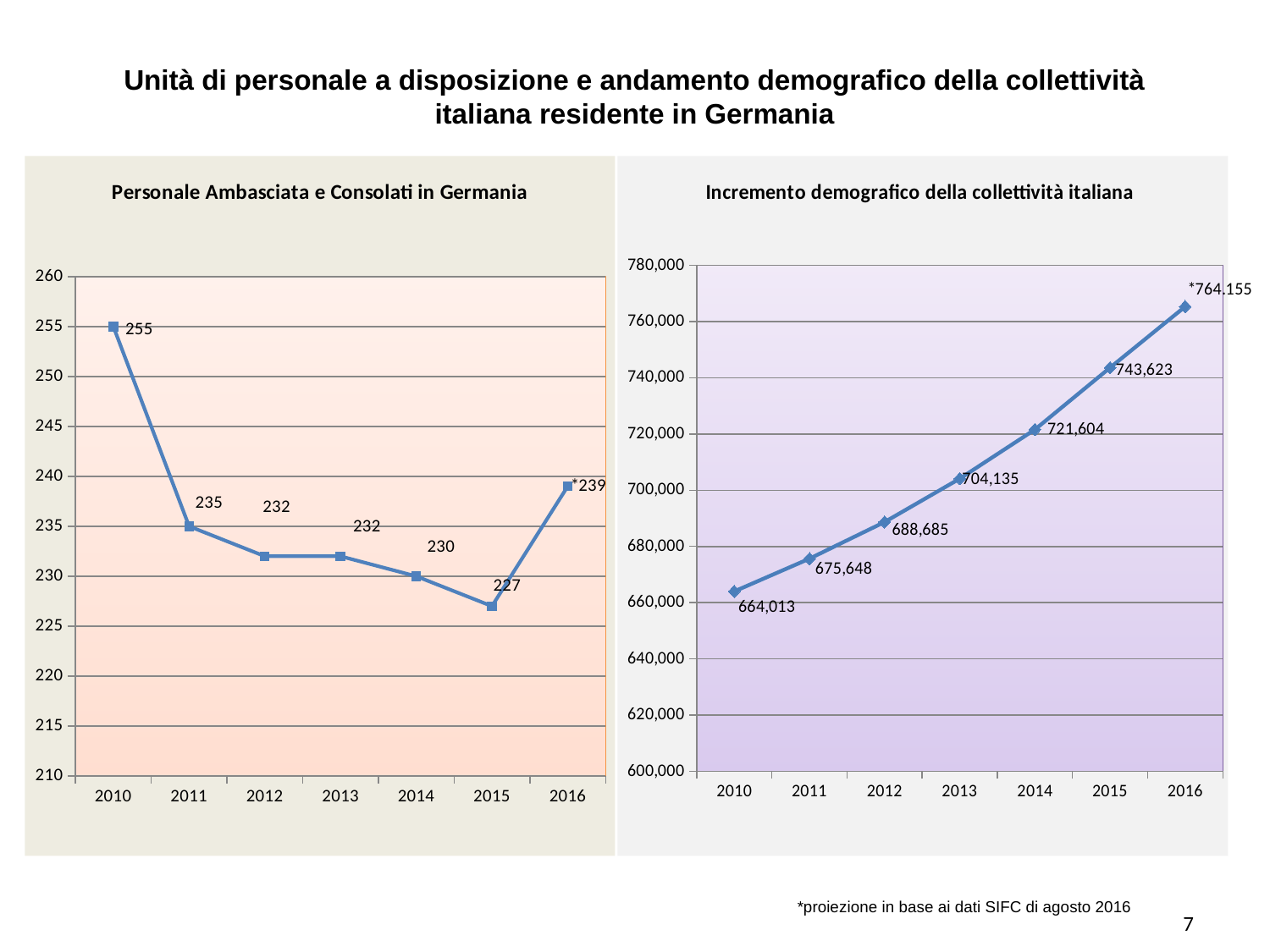
In the chart 'Personale Ambasciata e Consolati in Germania', what is the value for 2010? 255 In the chart 'Incremento demografico della collettività italiana', what is the value for 2013? 704,135 In the chart 'Incremento demografico della collettività italiana', is the value for 2014 greater or less than 720,000? greater In the chart 'Personale Ambasciata e Consolati in Germania', how many years are plotted on the x axis? 7 In the chart 'Personale Ambasciata e Consolati in Germania', what is the value for 2015? 227 In the chart 'Personale Ambasciata e Consolati in Germania', what is the difference between the values for 2010 and 2011? 20 In the chart 'Incremento demografico della collettività italiana', do the values rise or fall from 2010 to 2016? rise What kind of chart is 'Incremento demografico della collettività italiana'? line chart In the chart 'Personale Ambasciata e Consolati in Germania', which year has the lowest value? 2015 In the chart 'Personale Ambasciata e Consolati in Germania', which year has the highest value? 2010 In the chart 'Incremento demografico della collettività italiana', what is the difference between the values for 2011 and 2010? 11,635 In the chart 'Incremento demografico della collettività italiana', what is the value for 2016? *764,155